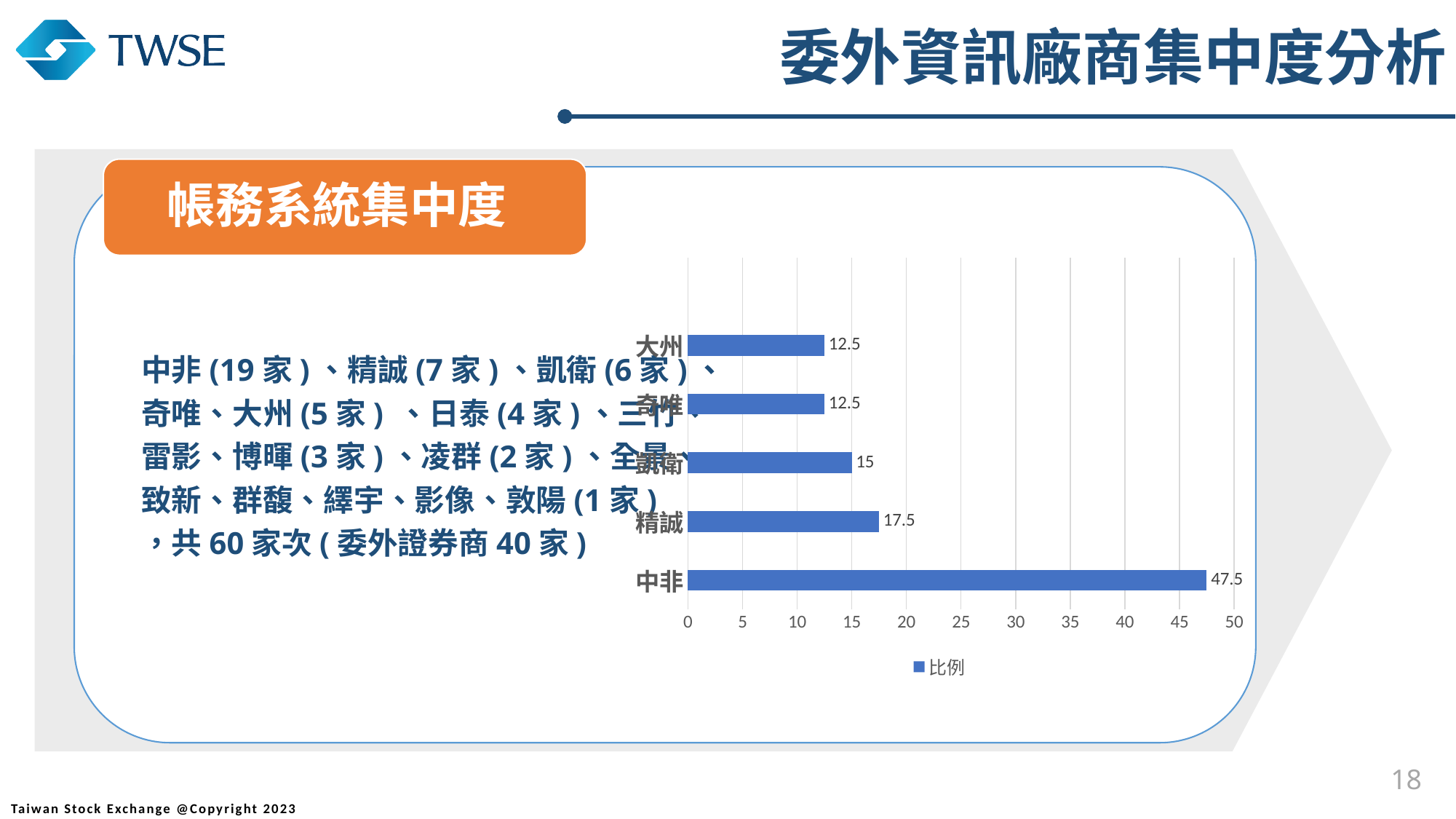
How many series does the chart legend list? 1 What is the value for 大州 in the bar chart? 12.5 What is the difference between the values for 精誠 and 大州? 5 What kind of chart is shown on the slide? bar chart Which category has the highest value in the bar chart? 中非 How many categories (bars) are shown in the chart? 5 What is the value for 精誠 in the bar chart? 17.5 Is the value for 中非 greater or less than 40? greater Which is larger, the value for 精誠 or the value for 大州? 精誠 What is the difference between the values for 中非 and 精誠? 30 What is the value for 中非 in the bar chart? 47.5 What is the legend entry shown below the chart? 比例